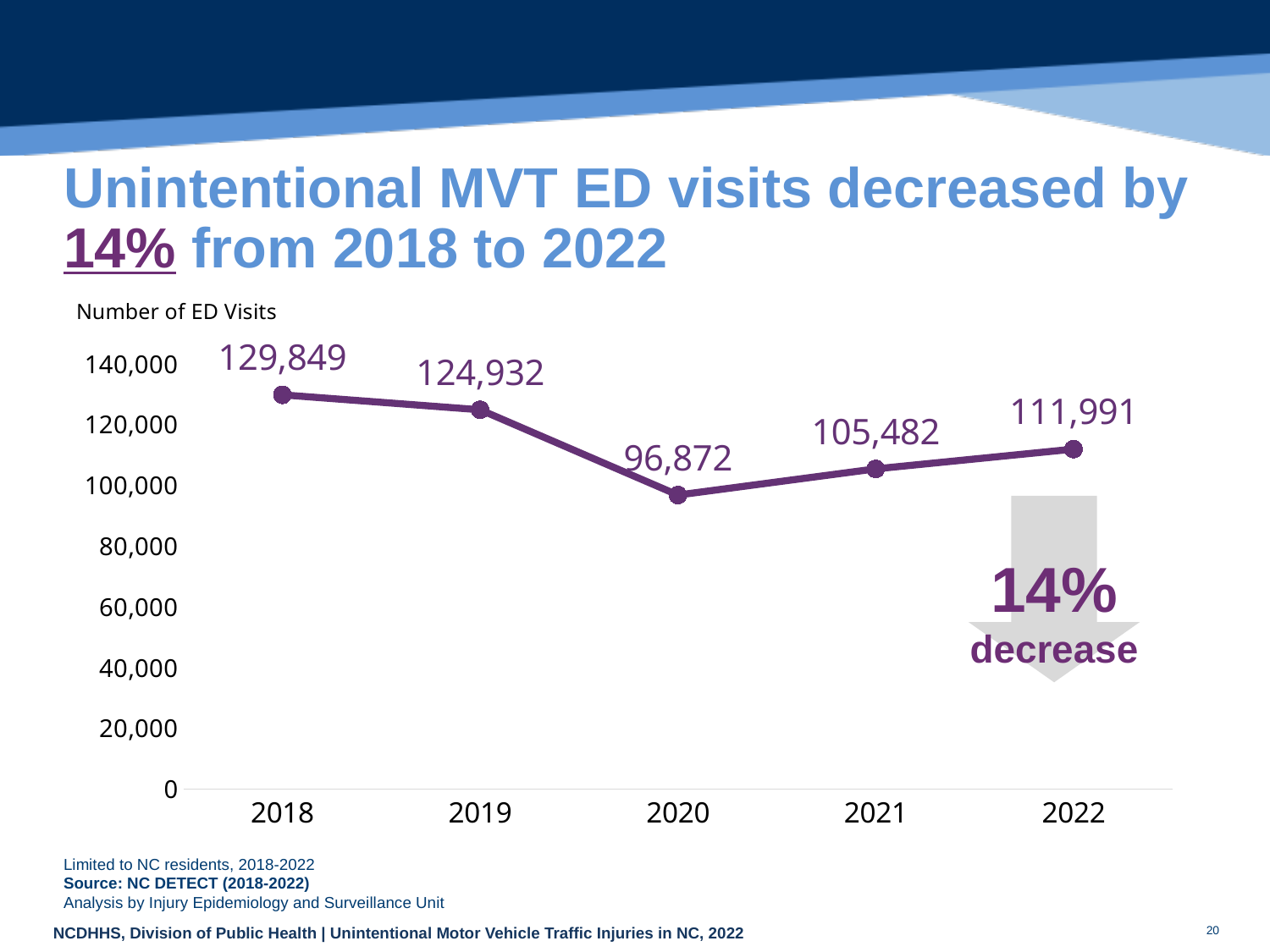
What is the difference in ED visits between 2018 and 2022? 17,858 Which year had more ED visits, 2019 or 2021? 2019 What was the number of ED visits in 2020? 96,872 Which year had the highest number of ED visits? 2018 How many years are plotted on the chart? 5 Which year had the lowest number of ED visits? 2020 What kind of chart is shown on the slide? line chart What was the number of ED visits in 2018? 129,849 Did the number of ED visits rise or fall from 2018 to 2020? fall What was the number of ED visits in 2022? 111,991 Is the value for 2020 greater or less than 100,000? less What is the difference in ED visits between 2021 and 2020? 8,610